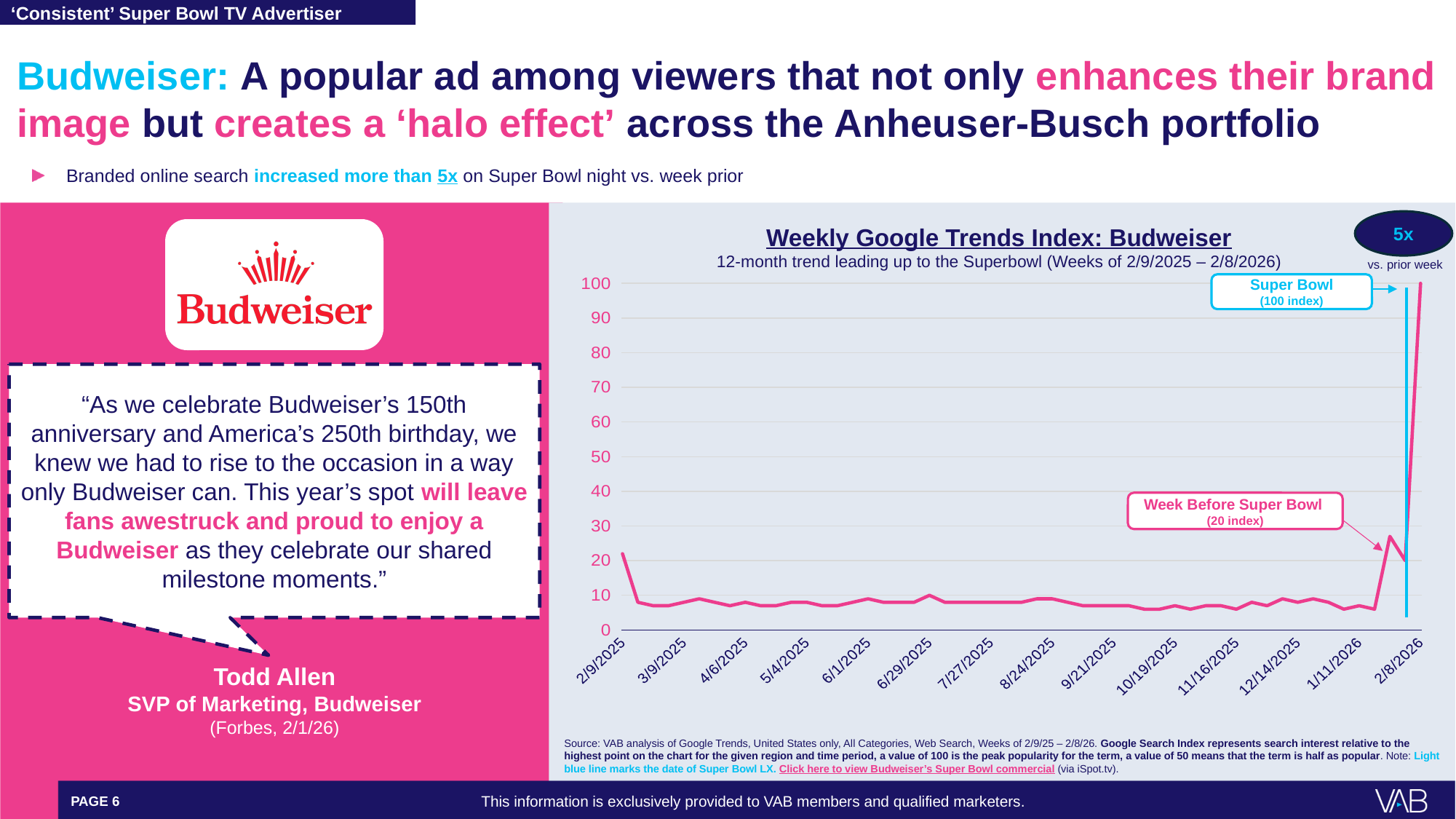
Which week has the highest Google Trends index value? 2/8/2026 (Super Bowl week) What type of chart is shown on the slide? line chart How many date labels are shown on the x axis? 14 Is the index value for the week of 8/24/2025 greater or less than 20? less Which is larger, the index for the Super Bowl week or the index for the week before the Super Bowl? Super Bowl week What does the light blue vertical line on the chart mark? the date of Super Bowl LX What is the difference between the Super Bowl week index and the week-before index? 80 What is the Google Trends index value for the Super Bowl week? 100 Is the index value for the week of 2/9/2025 greater or less than 30? less How does the index behave across the 12-month period before the final spike? stays roughly flat at low values What is the Google Trends index value for the week before the Super Bowl? 20 What is the title of the chart? Weekly Google Trends Index: Budweiser